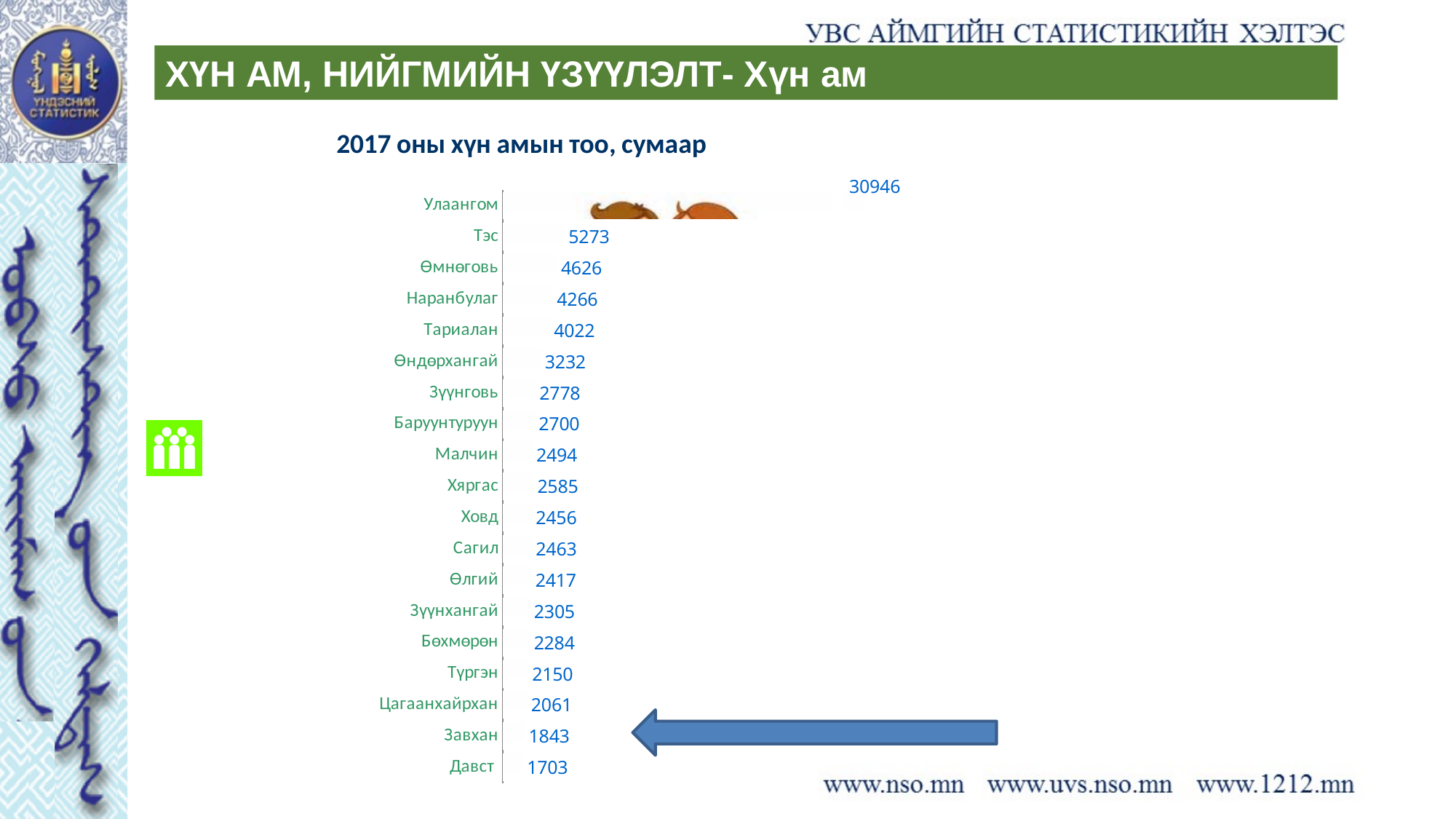
What is the title of the chart? 2017 оны хүн амын тоо, сумаар Which has a larger value, Наранбулаг or Тариалан? Наранбулаг Which category has the highest value? Улаангом What is the value shown for Давст? 1703 What is the population value shown for Улаангом? 30946 What is the value shown for Тэс? 5273 What kind of chart is shown on the slide? Bar chart What is the difference between the values for Завхан and Давст? 140 Which category has the lowest value? Давст What is the value shown for Баруунтуруун? 2700 How many categories (soums) are shown in the chart? 19 What is the difference between the values for Тэс and Өмнөговь? 647